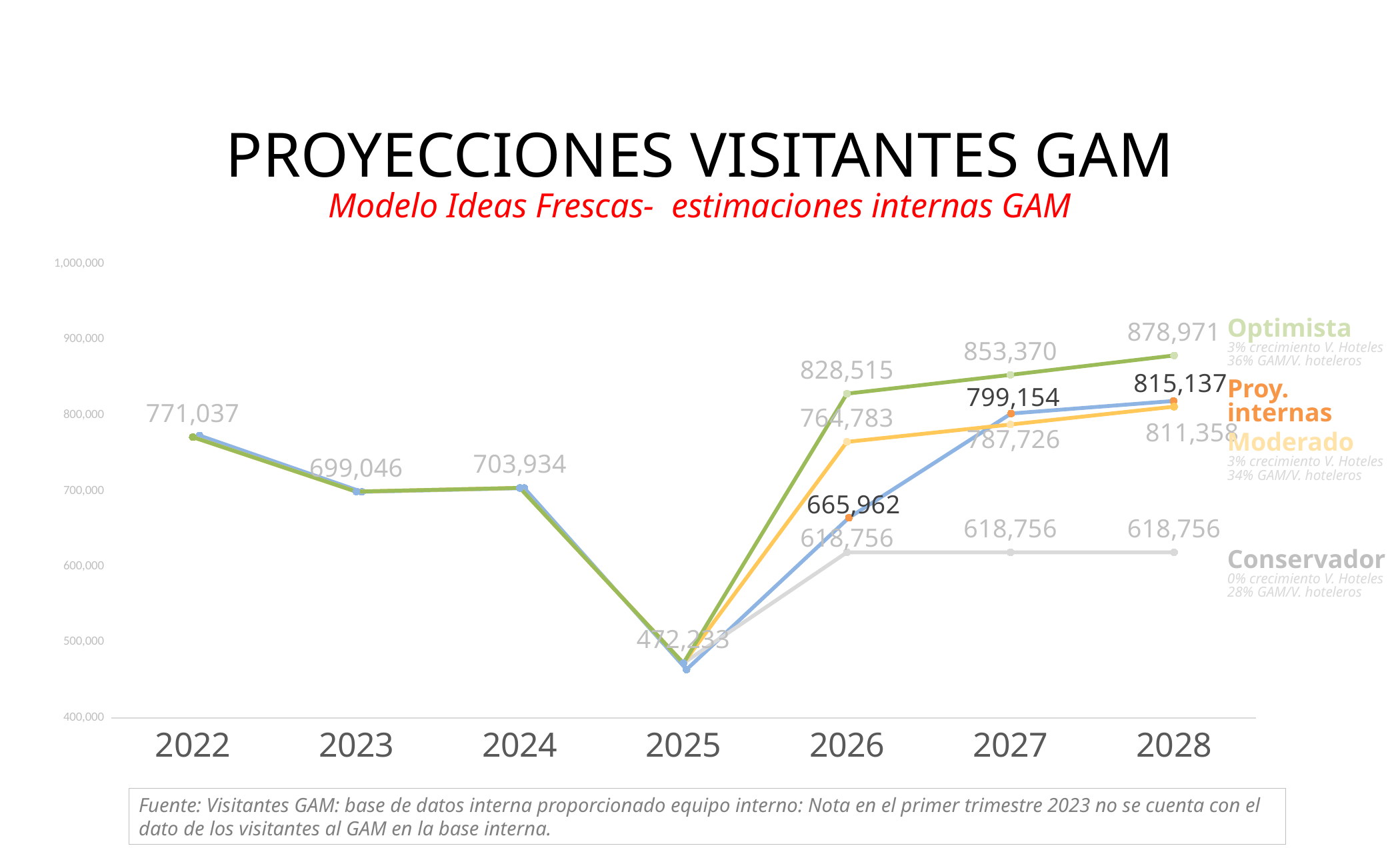
What is the Optimista projection for 2028? 878,971 What is the difference between the Optimista and Moderado projections for 2028? 67,613 What is the number of visitors shown for 2022? 771,037 What is the number of visitors shown for 2025? 472,233 What is the Conservador projection for 2027? 618,756 Do the visitor numbers rise or fall from 2022 to 2025? Fall What is the Proy. internas value for 2027? 799,154 What kind of chart is shown on the slide? Line chart What is the Moderado projection for 2026? 764,783 Which year has the lowest number of visitors on the chart? 2025 Which is higher in 2026, the Optimista projection or the Moderado projection? Optimista How many years are shown on the x axis? 7